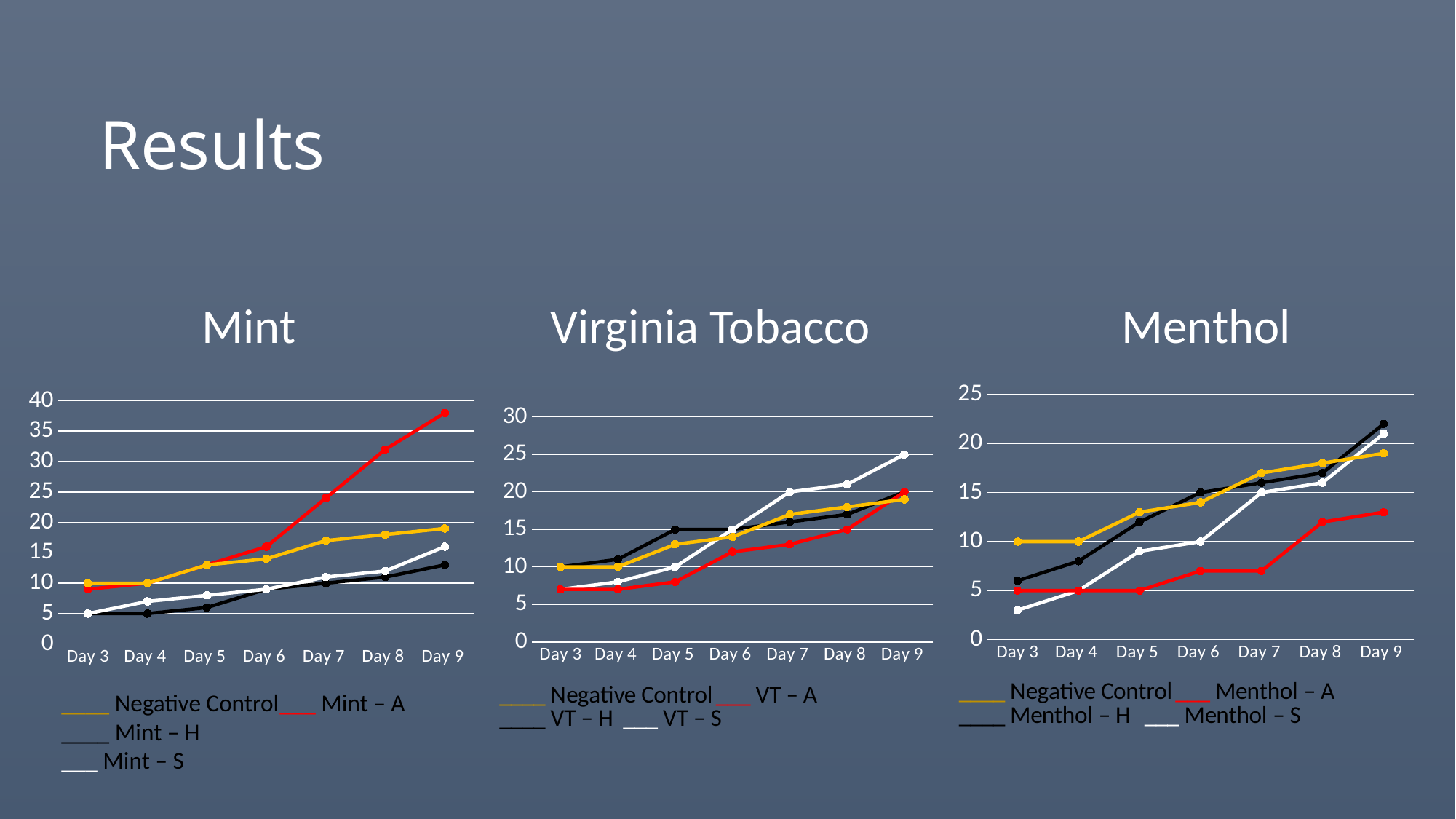
In the Menthol chart, is the value of Menthol – A on Day 9 greater or less than 15? less How many days are plotted along the x axis of the Menthol chart? 7 How many series does the legend of the Virginia Tobacco chart list? 4 In the Menthol chart, does the Menthol – H series rise or fall from Day 3 to Day 9? rise In the Virginia Tobacco chart, which series has the lowest value on Day 3? VT – A and VT – S (tied at 7) In the Virginia Tobacco chart, what is the value of VT – S on Day 9? 25 In the Mint chart, what is the value of Mint – H on Day 3? 5 In the Mint chart, which series has the highest value on Day 9? Mint – A What kind of chart is the Mint chart? line chart In the Virginia Tobacco chart, what is the value of VT – A on Day 9? 20 In the Mint chart, is the value of Mint – A on Day 9 greater or less than 35? greater In the Menthol chart, what is the value of Negative Control on Day 3? 10